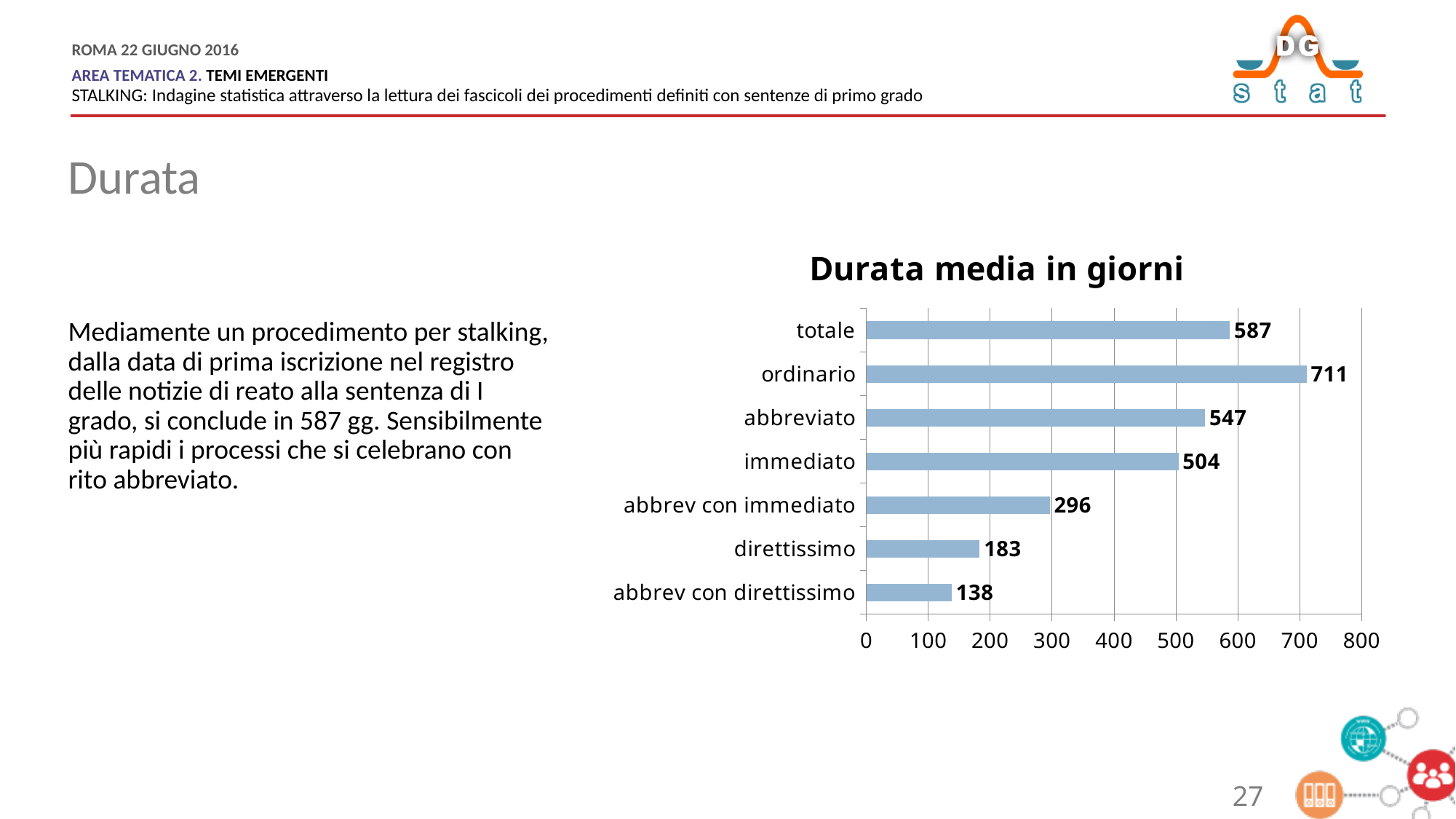
What is the difference between the values for 'ordinario' and 'totale'? 124 Is the value for 'abbreviato' greater or less than 500? greater Which is larger, the value for 'direttissimo' or the value for 'abbrev con immediato'? abbrev con immediato What is the difference between the values for 'abbreviato' and 'immediato'? 43 Which category has the highest value? ordinario What kind of chart is shown on the slide? bar chart What is the title of the chart? Durata media in giorni What is the value for 'abbrev con direttissimo'? 138 How many categories are shown in the chart? 7 What is the value for 'ordinario' in the chart? 711 Which category has the lowest value? abbrev con direttissimo What is the value for 'immediato'? 504